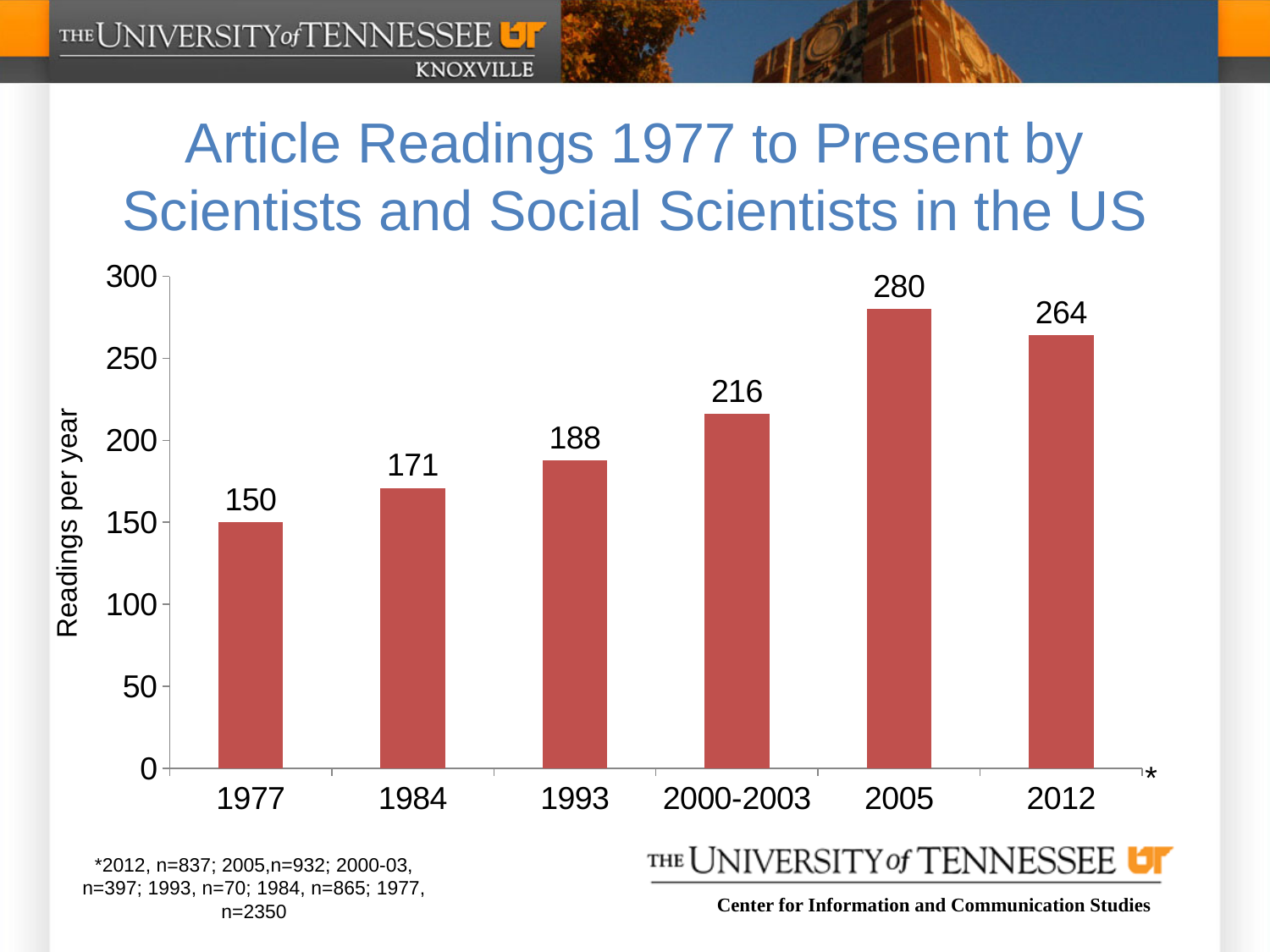
What is the label of the y axis? Readings per year What is the readings per year value for 1977? 150 What is the readings per year value for 2012? 264 What kind of chart is shown on the slide? Bar chart Is the value for 2000-2003 greater or less than 200? greater What is the difference in readings per year between 2005 and 2012? 16 How many time periods are shown on the x axis? 6 What is the difference in readings per year between 1993 and 1984? 17 Which has more readings per year, 1984 or 1993? 1993 Which year has the highest readings per year? 2005 What is the readings per year value for 2000-2003? 216 Which year has the lowest readings per year? 1977